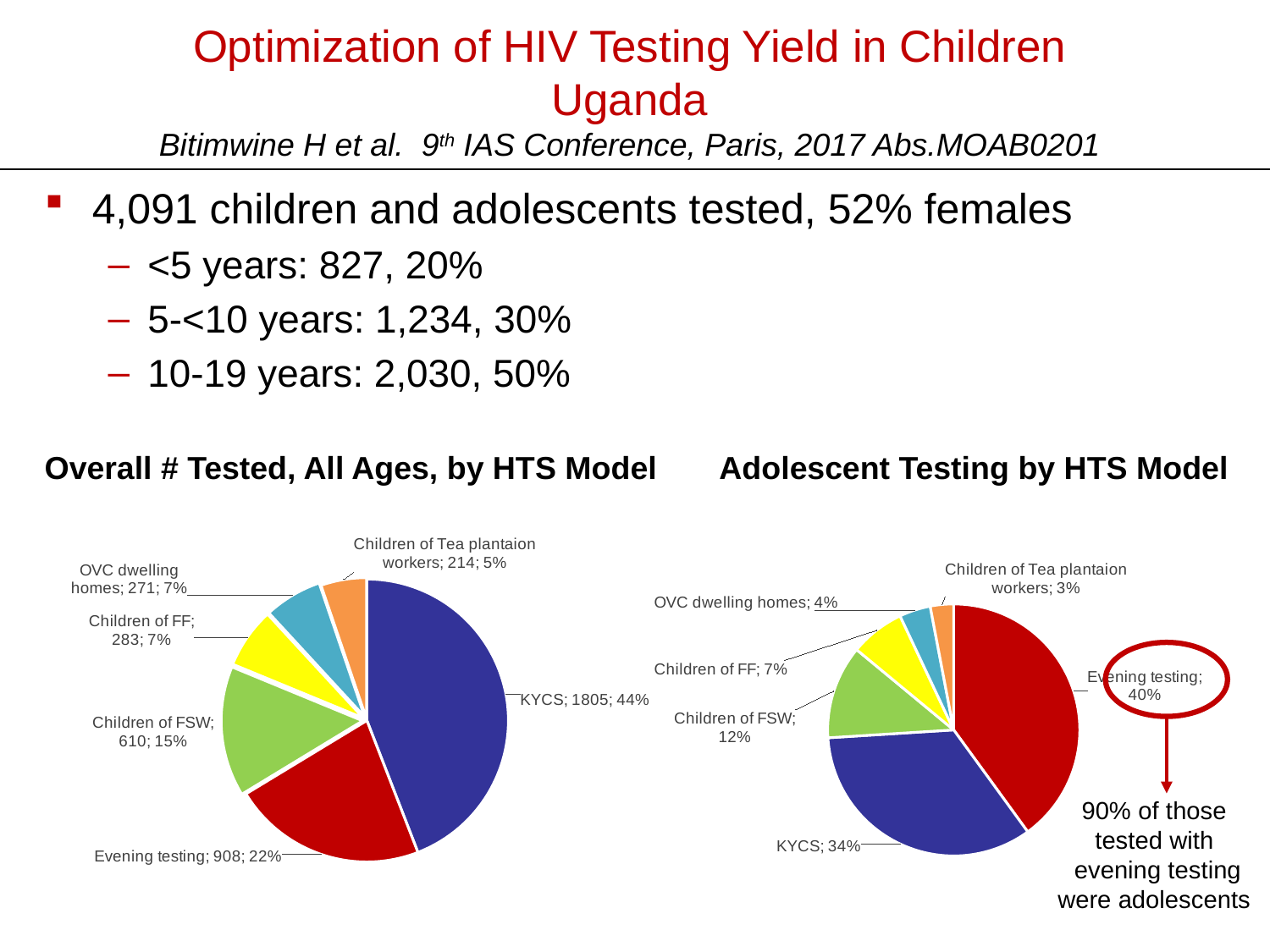
In the 'Overall # Tested, All Ages, by HTS Model' chart, what share of the pie is Evening testing? 22% In the 'Adolescent Testing by HTS Model' chart, what share is Evening testing? 40% In the 'Adolescent Testing by HTS Model' chart, what share is KYCS? 34% In the 'Overall # Tested, All Ages, by HTS Model' chart, which HTS model has the smallest slice? Children of Tea plantaion workers In the 'Overall # Tested, All Ages, by HTS Model' chart, which HTS model has the largest slice? KYCS In the 'Adolescent Testing by HTS Model' chart, which is larger: Children of FSW or Children of FF? Children of FSW In the 'Overall # Tested, All Ages, by HTS Model' chart, how many Children of FSW were tested? 610 In the 'Overall # Tested, All Ages, by HTS Model' chart, how many were tested through KYCS? 1805 In the 'Adolescent Testing by HTS Model' chart, which HTS model has the largest share? Evening testing What type of chart is used for 'Adolescent Testing by HTS Model'? Pie chart In the 'Overall # Tested, All Ages, by HTS Model' chart, how many HTS model categories are shown? 6 In the 'Overall # Tested, All Ages, by HTS Model' chart, what is the difference between the number tested through KYCS and through Evening testing? 897